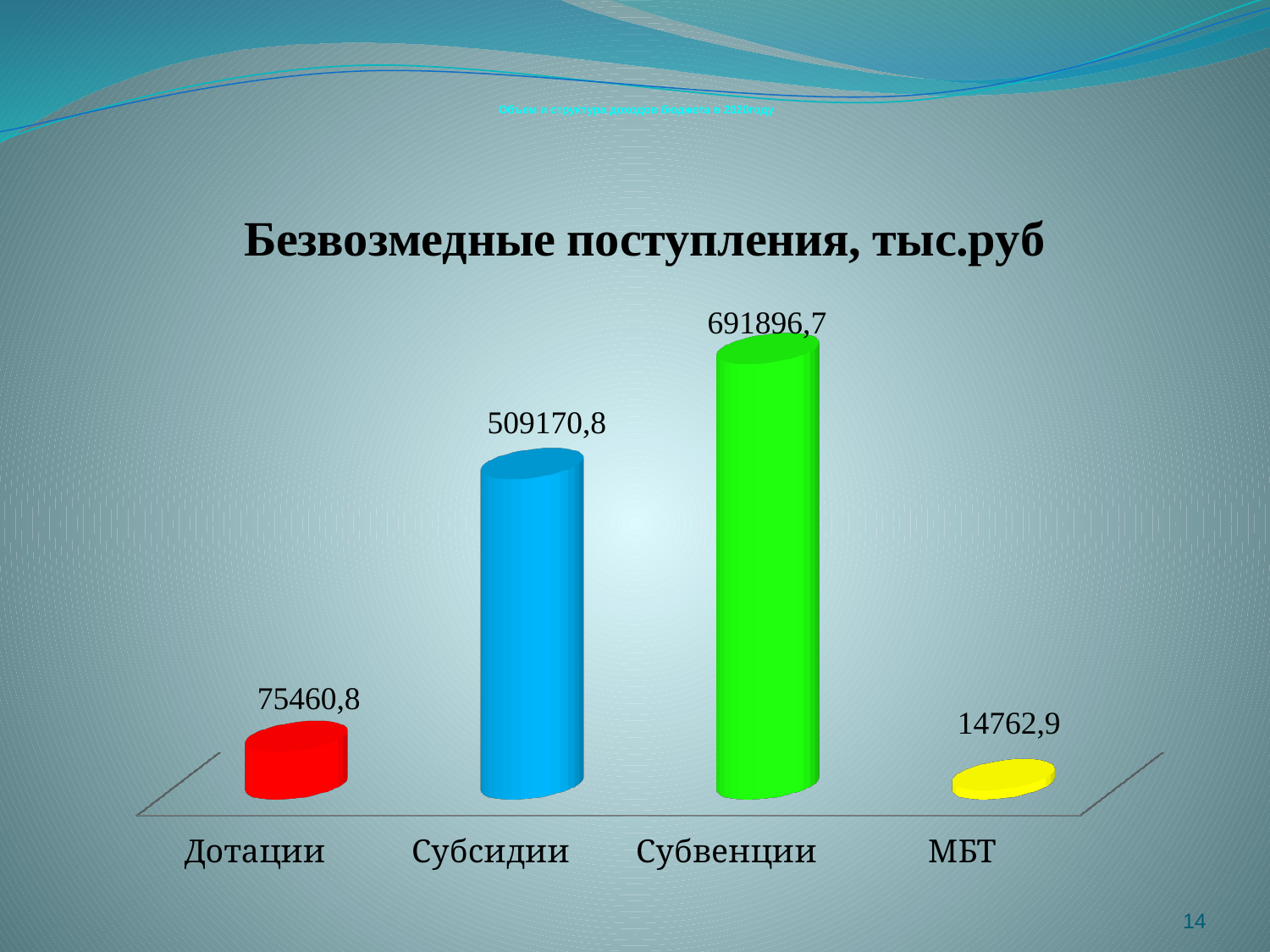
What is the value for Субсидии? 509170,8 What is the value for Дотации? 75460,8 What is the value for Субвенции? 691896,7 What is the title of the chart? Безвозмедные поступления, тыс.руб What kind of chart is shown on the slide? Bar chart How many categories are shown in the chart? 4 Which is larger, the value for Дотации or the value for МБТ? Дотации What is the value for МБТ? 14762,9 Which category has the highest value? Субвенции What is the difference between the values for Дотации and МБТ? 60697,9 What is the difference between the values for Субвенции and Субсидии? 182725,9 Which category has the lowest value? МБТ